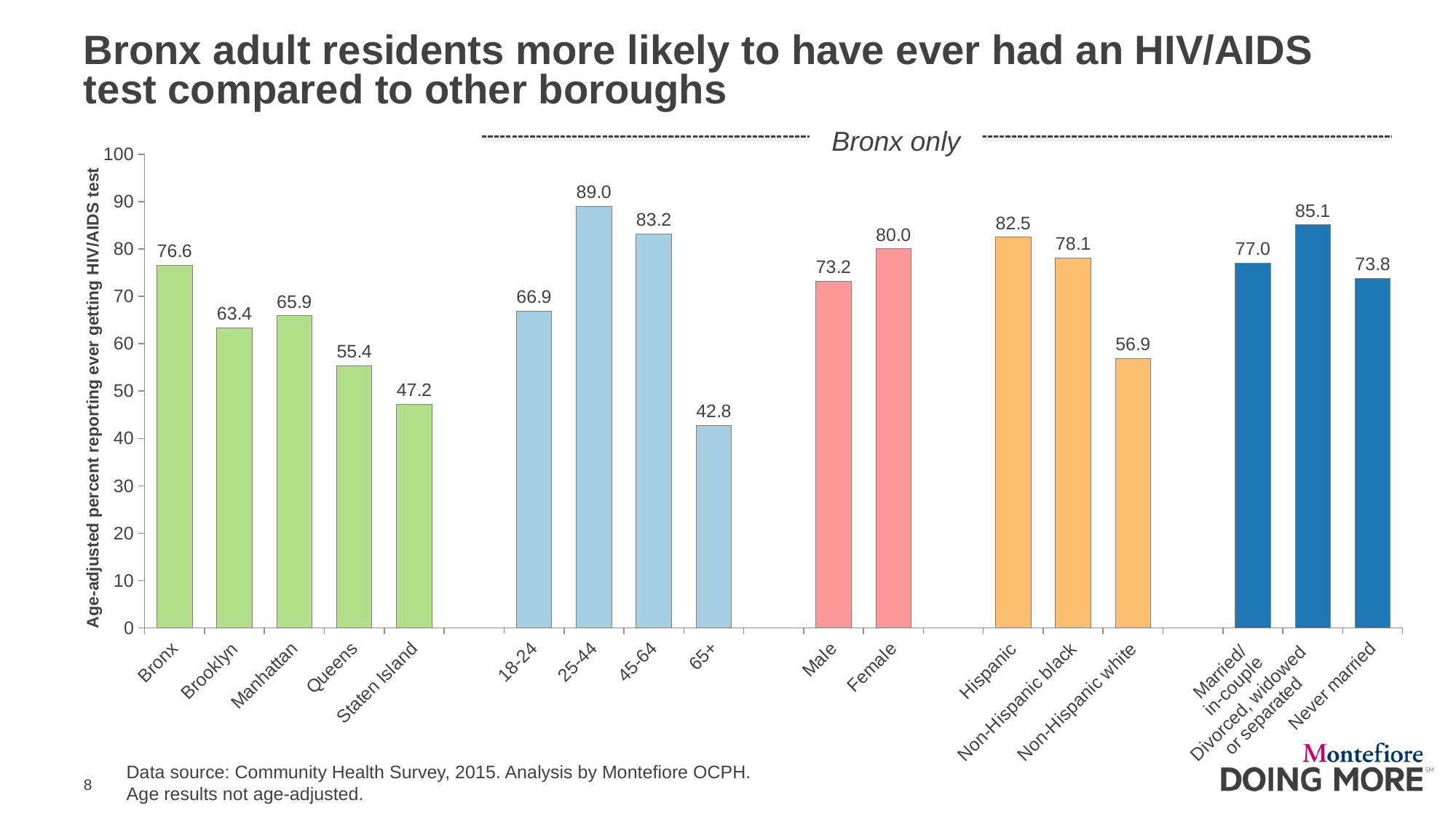
Among the five boroughs, which has the lowest value? Staten Island Which is larger, the value for Hispanic or the value for Non-Hispanic black? Hispanic What is the value for Bronx? 76.6 What is the value for Staten Island? 47.2 What is the value for the 25-44 age group? 89.0 What is the label on the vertical axis? Age-adjusted percent reporting ever getting HIV/AIDS test What kind of chart is shown on the slide? Bar chart What is the value for Non-Hispanic white? 56.9 Which category has the lowest value on the chart? 65+ Which category has the highest value on the chart? 25-44 How many bars are plotted on the chart? 17 What is the difference between the values for Female and Male? 6.8